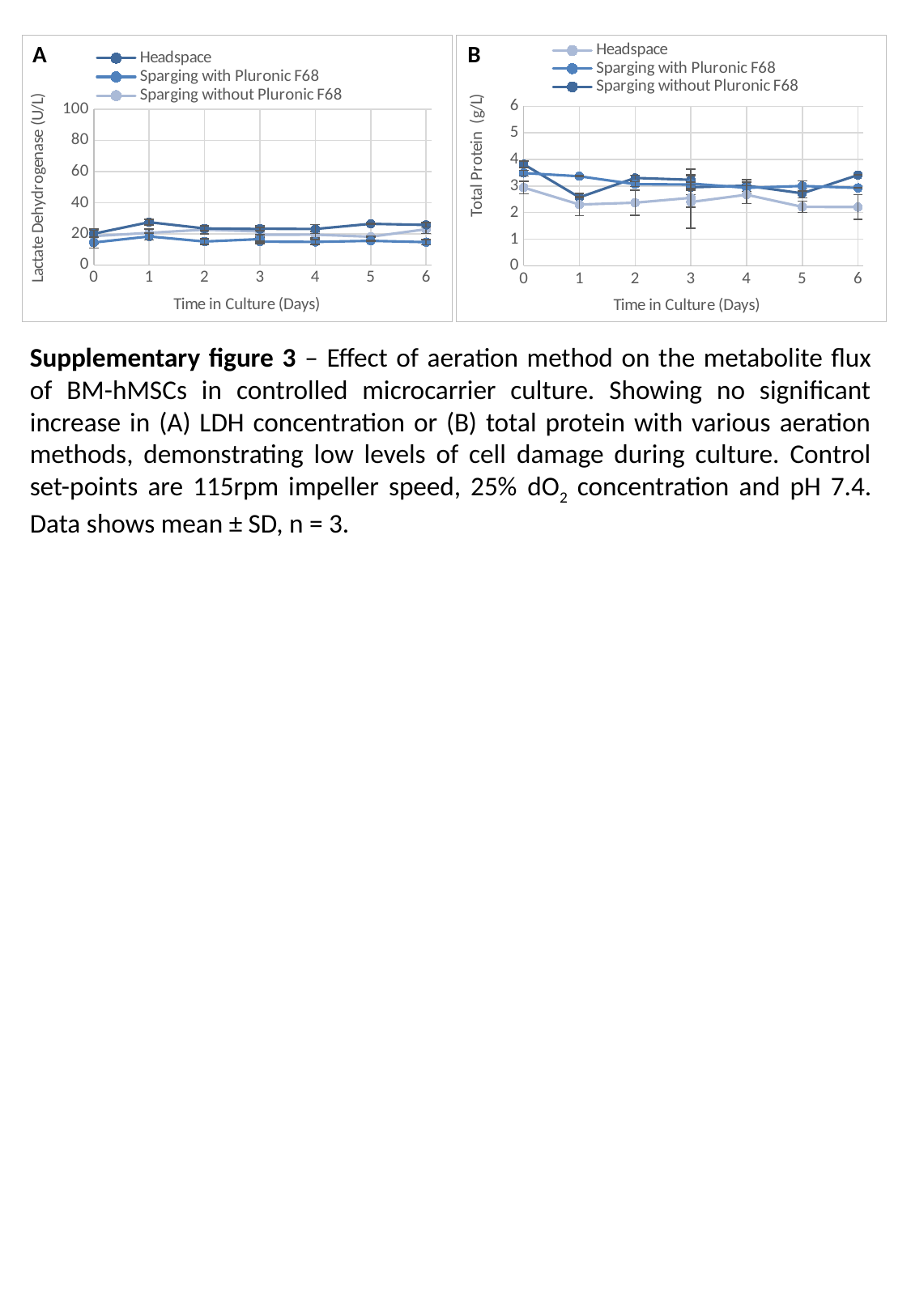
In chart A (Lactate Dehydrogenase), is the value for Headspace at day 5 greater or less than 40? less In chart B (Total Protein), which series has the lowest value at day 5? Headspace In chart A (Lactate Dehydrogenase), is the value for Sparging with Pluronic F68 at day 3 greater or less than 20? less What is the x-axis label of chart B? Time in Culture (Days) In chart B (Total Protein), is the value for Headspace at day 5 greater or less than 3? less In chart A (Lactate Dehydrogenase), which series has the highest value at day 1? Headspace In chart B (Total Protein), at day 1, which is larger: Sparging with Pluronic F68 or Headspace? Sparging with Pluronic F68 What is the y-axis label of chart A? Lactate Dehydrogenase (U/L) What kind of chart is chart A (Lactate Dehydrogenase)? line chart How many series does the legend of chart B (Total Protein) list? 3 How many time points are plotted along the x axis of chart A (Lactate Dehydrogenase)? 7